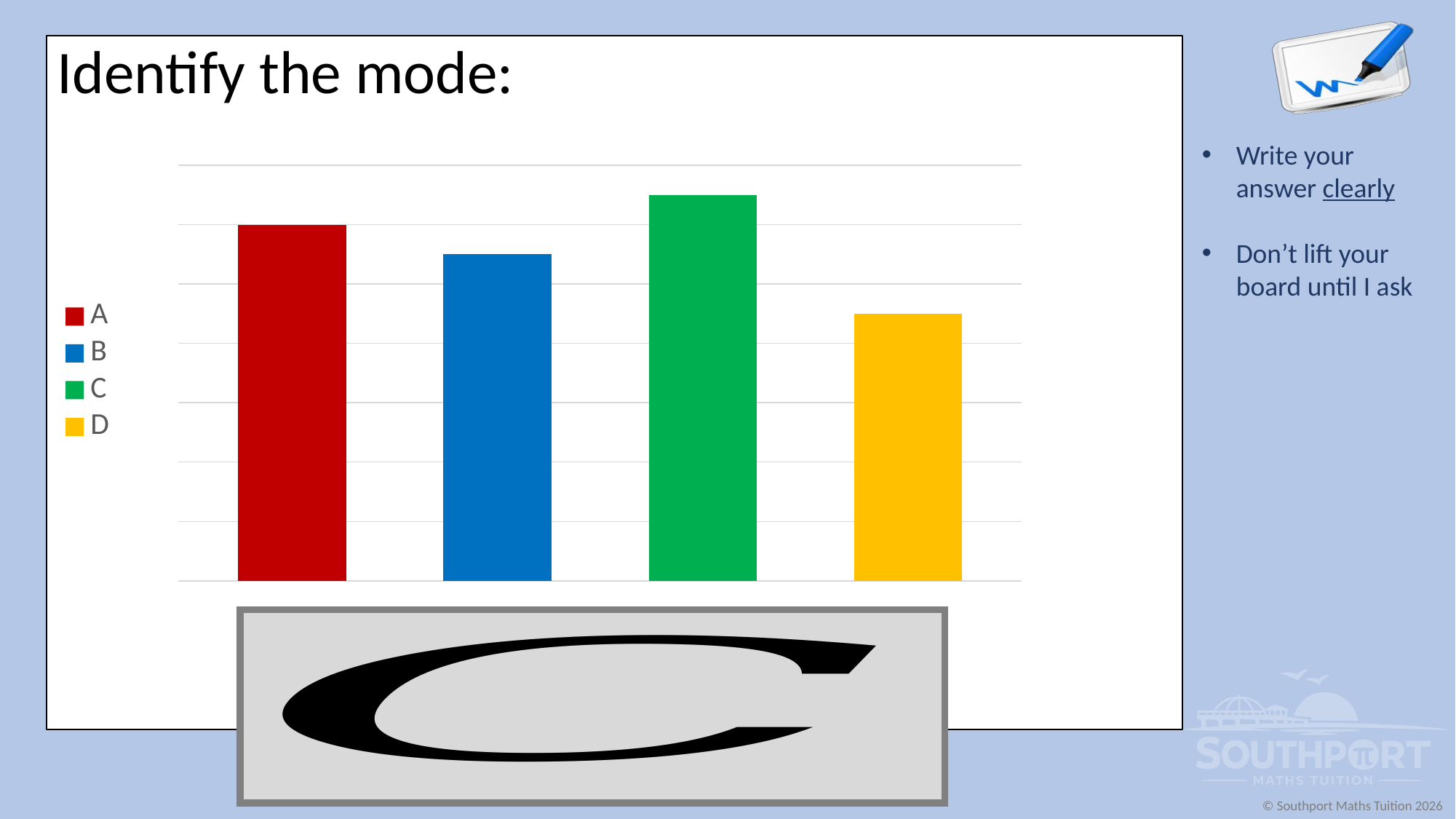
Which category has the tallest bar in the chart? C Which category has the shortest bar in the chart? D What is the title text above the chart? Identify the mode: Which bar is taller, C or A? C Which bar is taller, D or A? A Which bar is taller, B or D? B How many entries does the chart's legend list? 4 How many bars are plotted in the chart? 4 What kind of chart is shown on the slide? Bar chart What colour is the bar for category C? Green